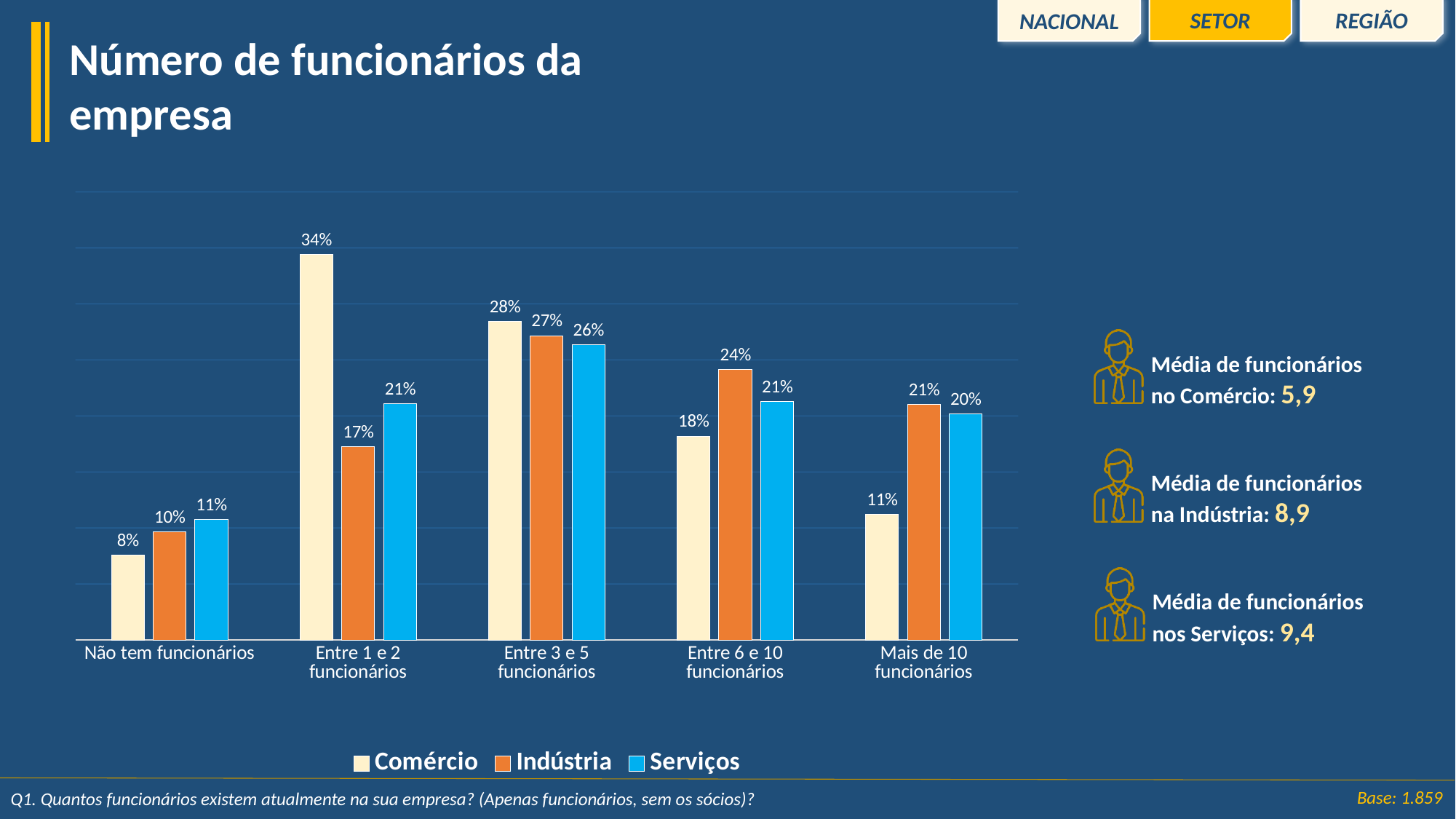
What is the value for Indústria in the 'Entre 6 e 10 funcionários' category? 24% What is the value for Serviços in the 'Entre 3 e 5 funcionários' category? 26% What is the value for Comércio in the 'Entre 1 e 2 funcionários' category? 34% How many series does the legend list? 3 In the 'Mais de 10 funcionários' category, which is larger: Comércio or Indústria? Indústria What is the value for Serviços in the 'Não tem funcionários' category? 11% What is the difference between the Comércio and Indústria values in the 'Entre 1 e 2 funcionários' category? 17% Which category has the lowest value for Indústria? Não tem funcionários Which category has the highest value for Comércio? Entre 1 e 2 funcionários What kind of chart is shown on the slide? Bar chart How many categories are shown on the x axis? 5 Which series is shown in orange in the legend? Indústria